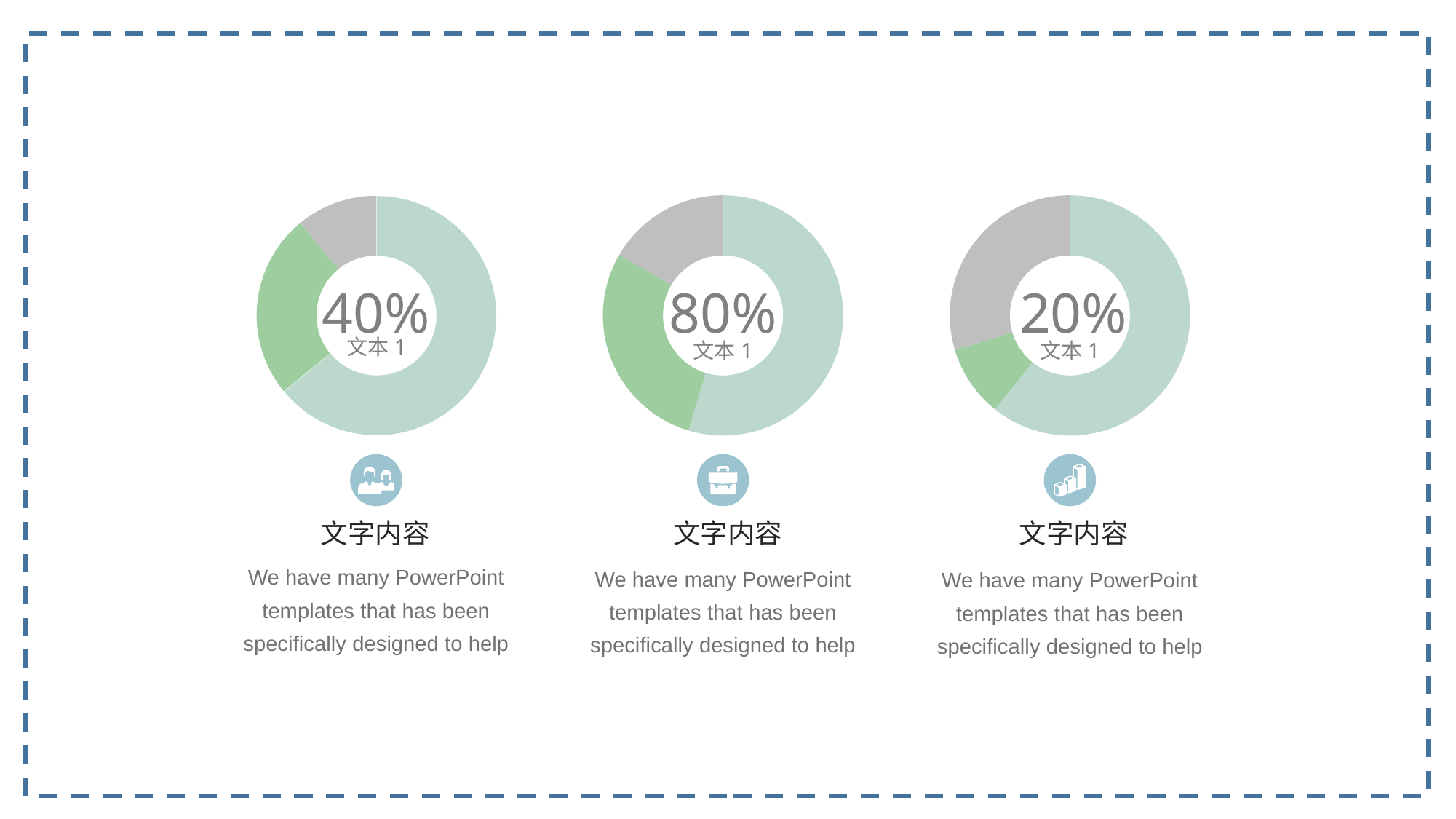
What kind of chart is shown on the left of the slide? doughnut chart How many doughnut charts are on the slide? 3 Which is larger, the percentage shown in the left chart or the percentage shown in the right chart? the left chart (40%) How many segments does the middle doughnut chart have? 3 What percentage is printed in the centre of the middle doughnut chart? 80% Which doughnut chart shows the highest percentage in its centre? the middle chart (80%) What percentage is printed in the centre of the right doughnut chart? 20% What colour is the largest segment of the right doughnut chart? light green Which doughnut chart shows the lowest percentage in its centre? the right chart (20%) What text label appears below the percentage in the centre of each doughnut chart? 文本 1 What is the difference between the percentage in the middle chart and the percentage in the left chart? 40% What percentage is printed in the centre of the left doughnut chart? 40%